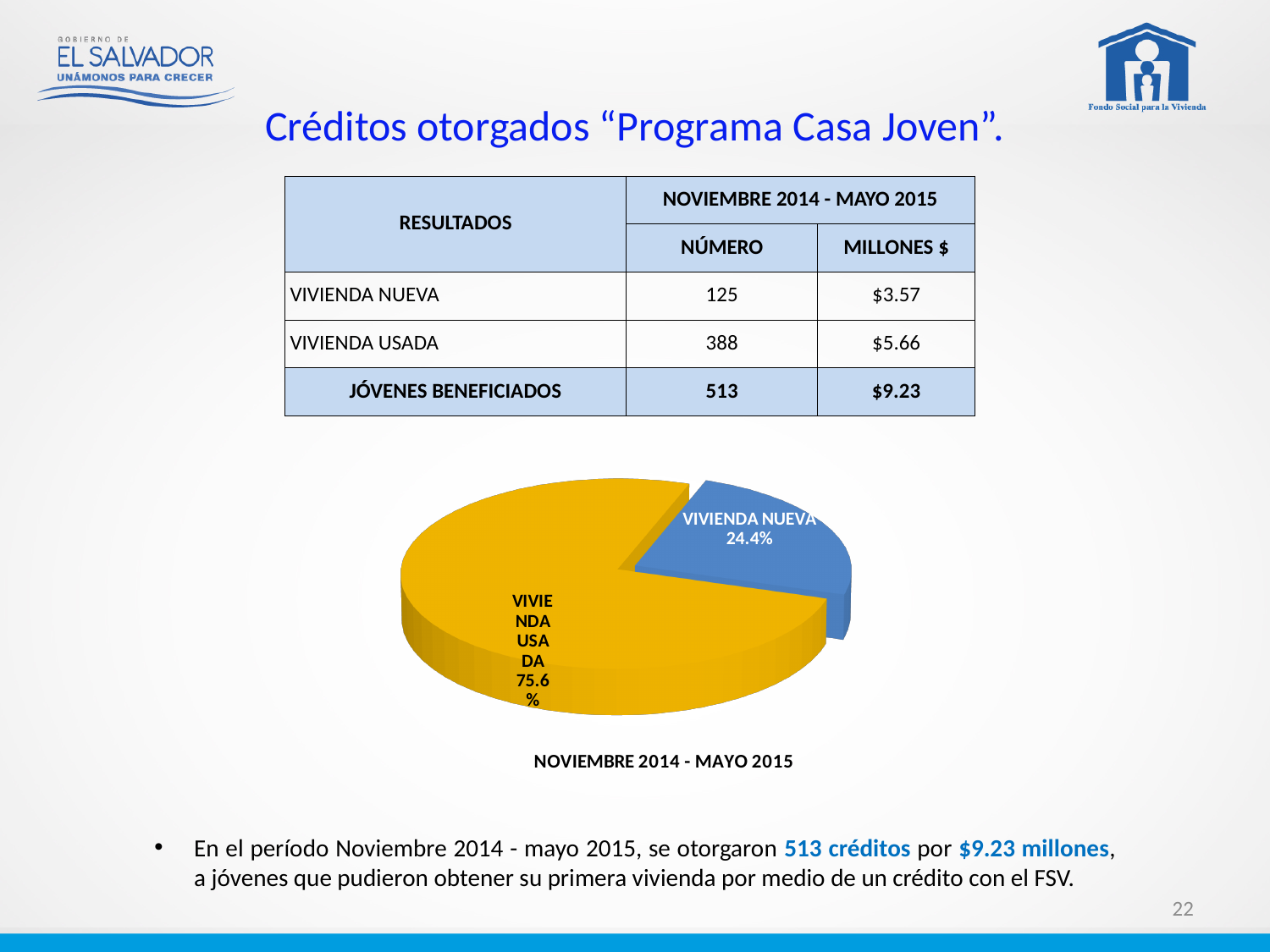
Is the share for VIVIENDA USADA greater or less than 50%? greater Which is larger in the pie chart, VIVIENDA NUEVA or VIVIENDA USADA? VIVIENDA USADA Which slice of the pie chart is the largest? VIVIENDA USADA Which slice of the pie chart is the smallest? VIVIENDA NUEVA What share of the pie does VIVIENDA NUEVA represent? 24.4% How many slices does the pie chart have? 2 What colour is the VIVIENDA NUEVA slice of the pie chart? Blue What kind of chart is shown on the slide? Pie chart What is the difference in percentage points between the VIVIENDA USADA and VIVIENDA NUEVA slices? 51.2 What is the title shown below the pie chart? NOVIEMBRE 2014 - MAYO 2015 What share of the pie does VIVIENDA USADA represent? 75.6%